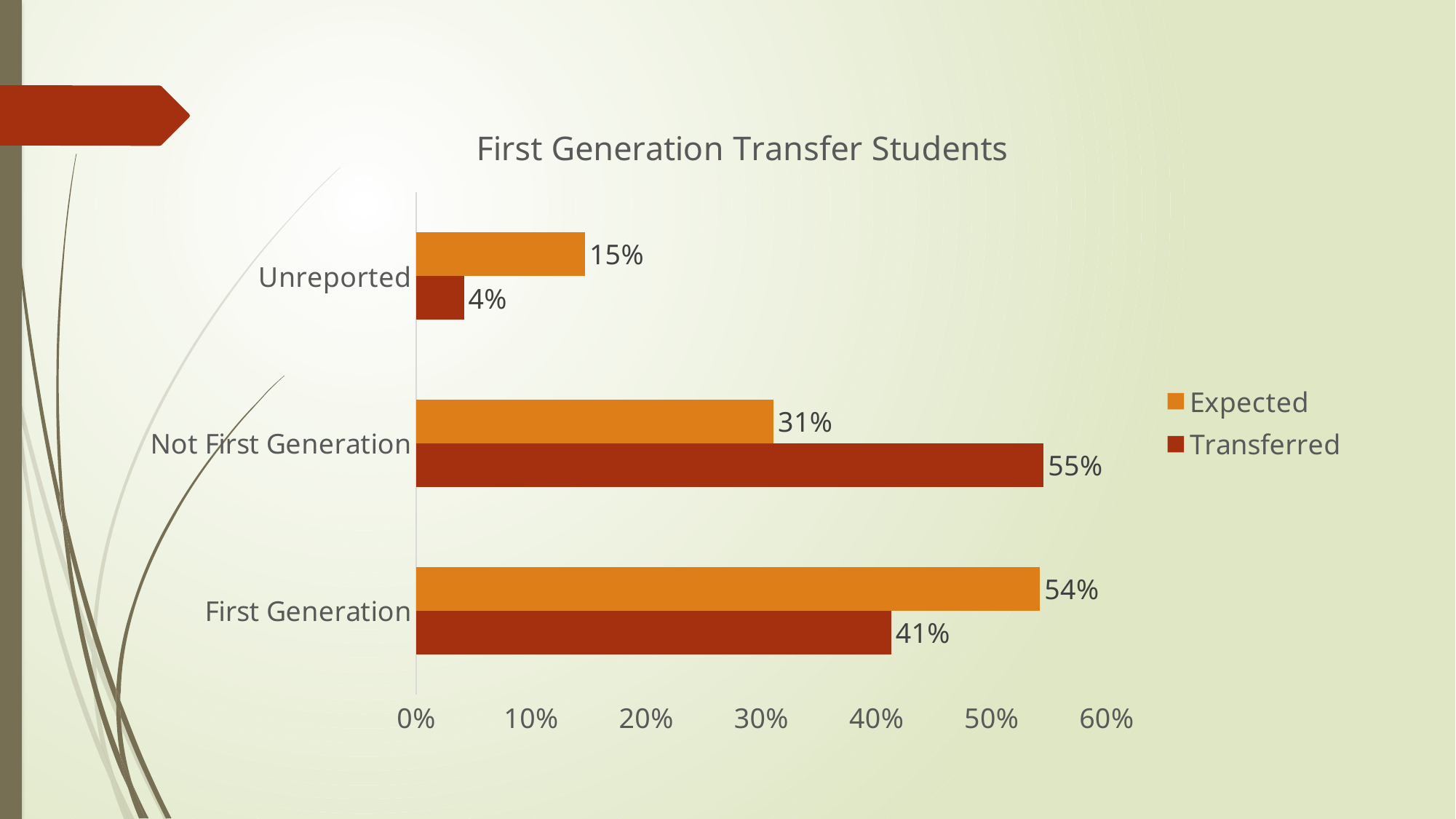
How many categories are shown on the chart? 3 What is the Transferred value for Unreported? 4% What is the difference between the Expected and Transferred values for Not First Generation? 24% Which category has the lowest Expected value? Unreported What is the difference between the Expected and Transferred values for Unreported? 11% How many series does the legend list? 2 Which is larger for First Generation, the Expected value or the Transferred value? Expected What is the Transferred value for Not First Generation? 55% What is the Expected value for First Generation? 54% What kind of chart is shown on the slide? Bar chart Which category has the highest Transferred value? Not First Generation What is the Expected value for Unreported? 15%